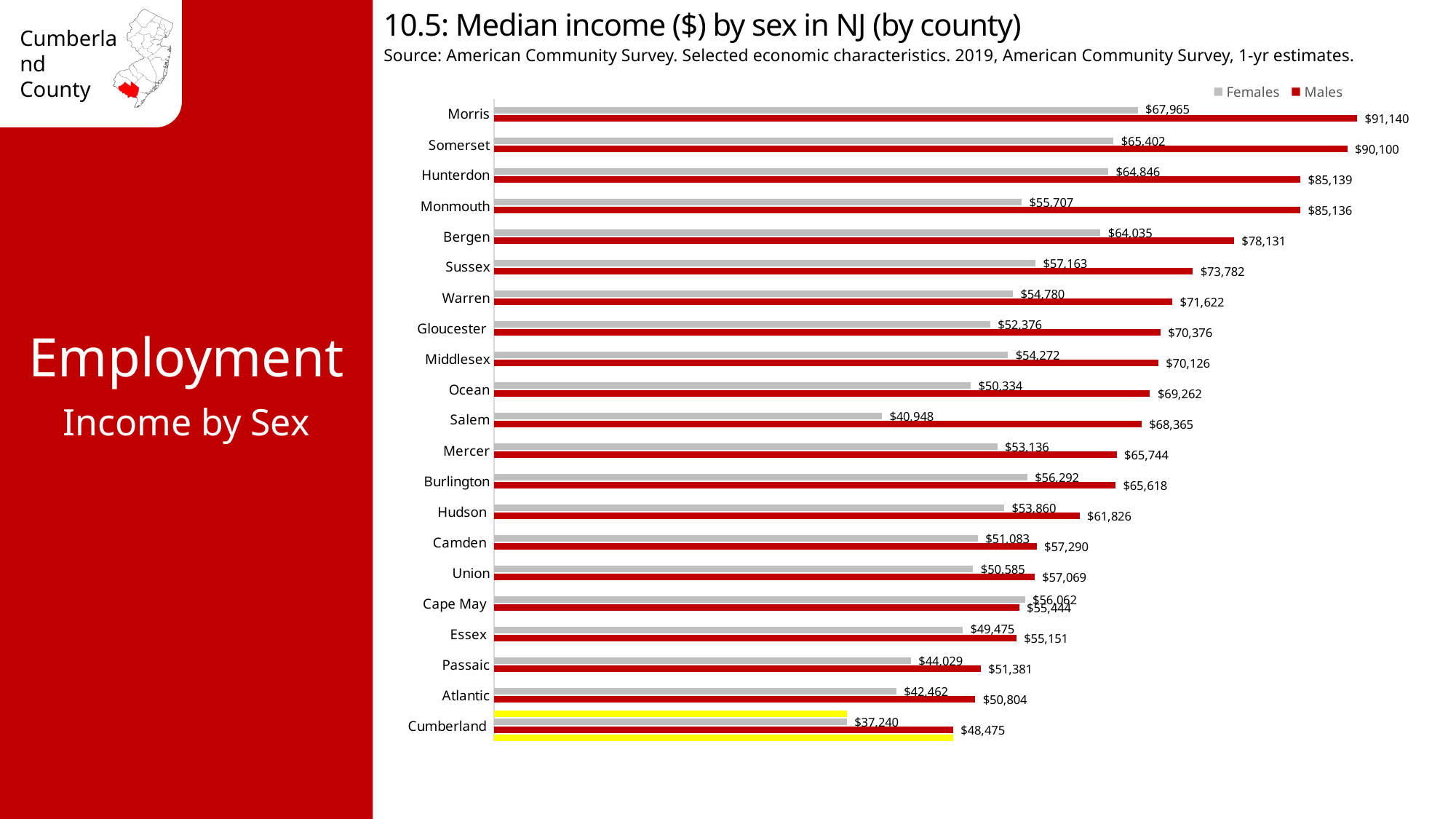
What is the median income for females in Morris County? $67,965 What is the difference between male and female median income in Cumberland County? $11,235 How many counties are shown in the chart? 21 What type of chart is shown on the slide? Bar chart What is the median income for males in Cumberland County? $48,475 How many series does the legend list? 2 Which county has the highest median income for males? Morris Which county has the lowest median income for females? Cumberland In Cape May County, is the median income higher for females or males? Females Which colour represents the Males series in the chart? Red What is the median income for females in Salem County? $40,948 What is the difference between male and female median income in Morris County? $23,175